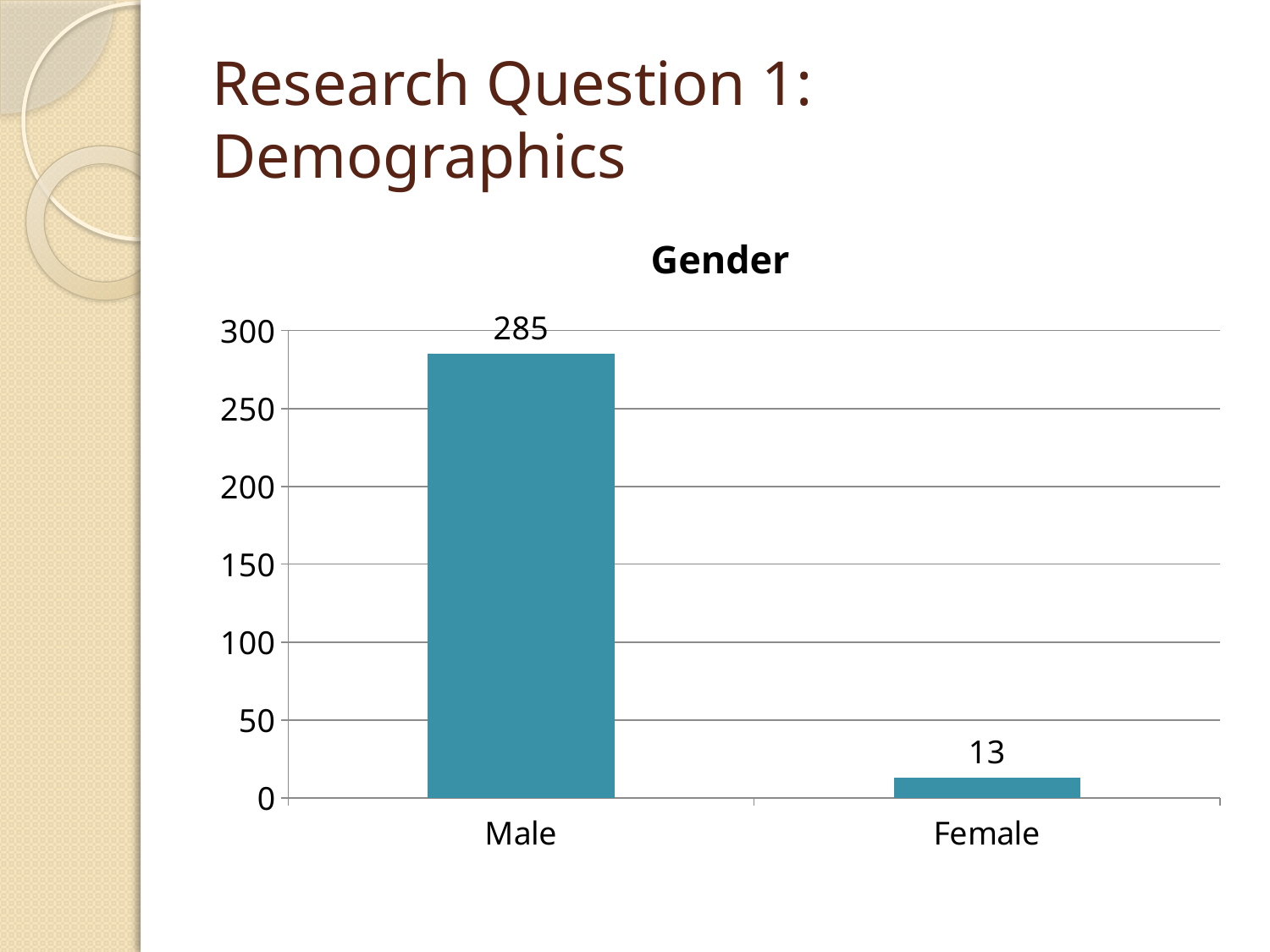
How many categories are shown in the Gender chart? 2 What is the difference between the Male and Female values in the Gender chart? 272 What is the value for Male in the Gender chart? 285 Which category has the highest value in the Gender chart? Male What kind of chart is shown on the slide? bar chart What is the value for Female in the Gender chart? 13 Is the value for Female greater or less than 50? less Which category has the lowest value in the Gender chart? Female Which is larger in the Gender chart, the value for Male or the value for Female? Male Is the value for Male greater or less than 250? greater What is the highest value shown on the vertical axis of the Gender chart? 300 What is the title of the chart on the slide? Gender